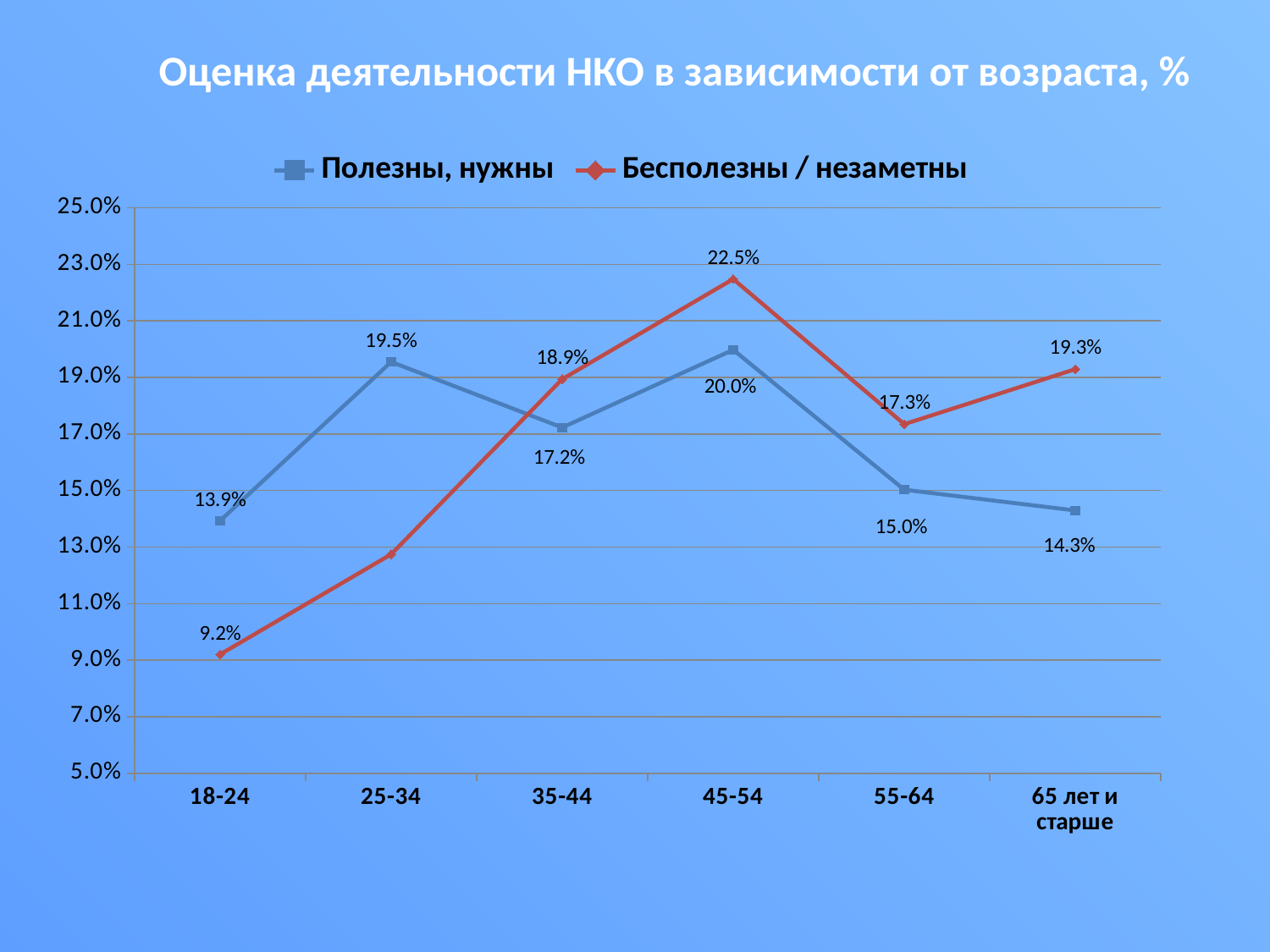
Which series has the larger value in the 35-44 age group? Бесполезны / незаметны What is the difference between "Бесполезны / незаметны" and "Полезны, нужны" in the 45-54 age group? 2.5% In which age group is the "Бесполезны / незаметны" series highest? 45-54 What is the title of the chart? Оценка деятельности НКО в зависимости от возраста, % Does the "Полезны, нужны" series rise or fall from 45-54 to 65 лет и старше? fall In which age group is the "Полезны, нужны" series lowest? 18-24 Is the value for "Бесполезны / незаметны" in the 25-34 age group greater or less than 11.0%? greater How many series does the legend list? 2 What kind of chart is shown on the slide? line chart How many age categories are shown on the x axis? 6 What is the value for "Бесполезны / незаметны" in the 45-54 age group? 22.5% What is the value for "Полезны, нужны" in the 25-34 age group? 19.5%